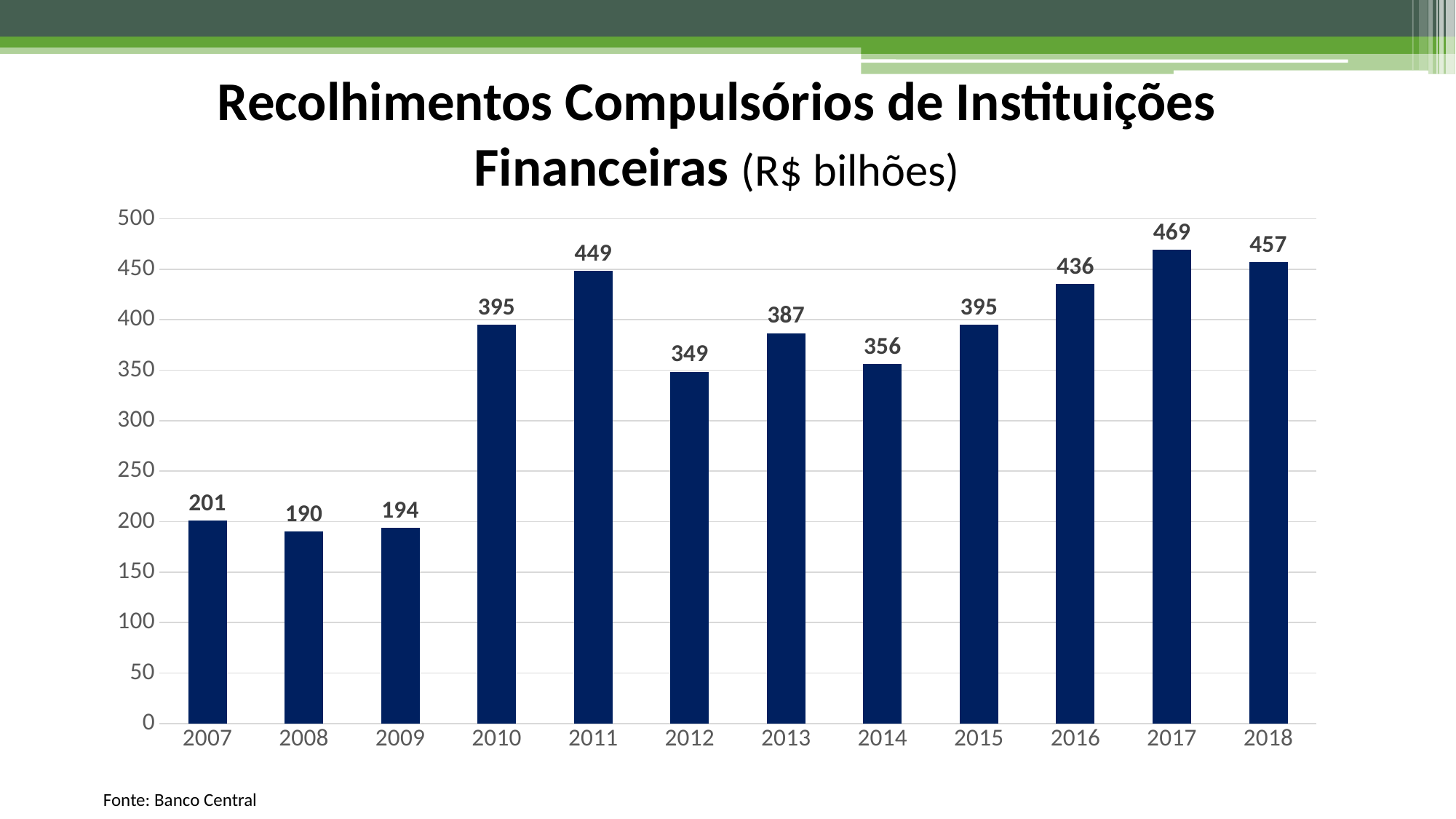
What is the difference between the values for 2017 and 2018? 12 How many years are shown on the x axis? 12 What kind of chart is shown on the slide? Bar chart What is the value for 2008? 190 Which year has the lowest value? 2008 Is the value for 2016 greater or less than 400? greater Which is larger, the value for 2012 or the value for 2013? 2013 What source is cited below the chart? Banco Central What is the value for 2014? 356 What is the value for 2011? 449 Which year has the highest value? 2017 What is the difference between the values for 2010 and 2007? 194